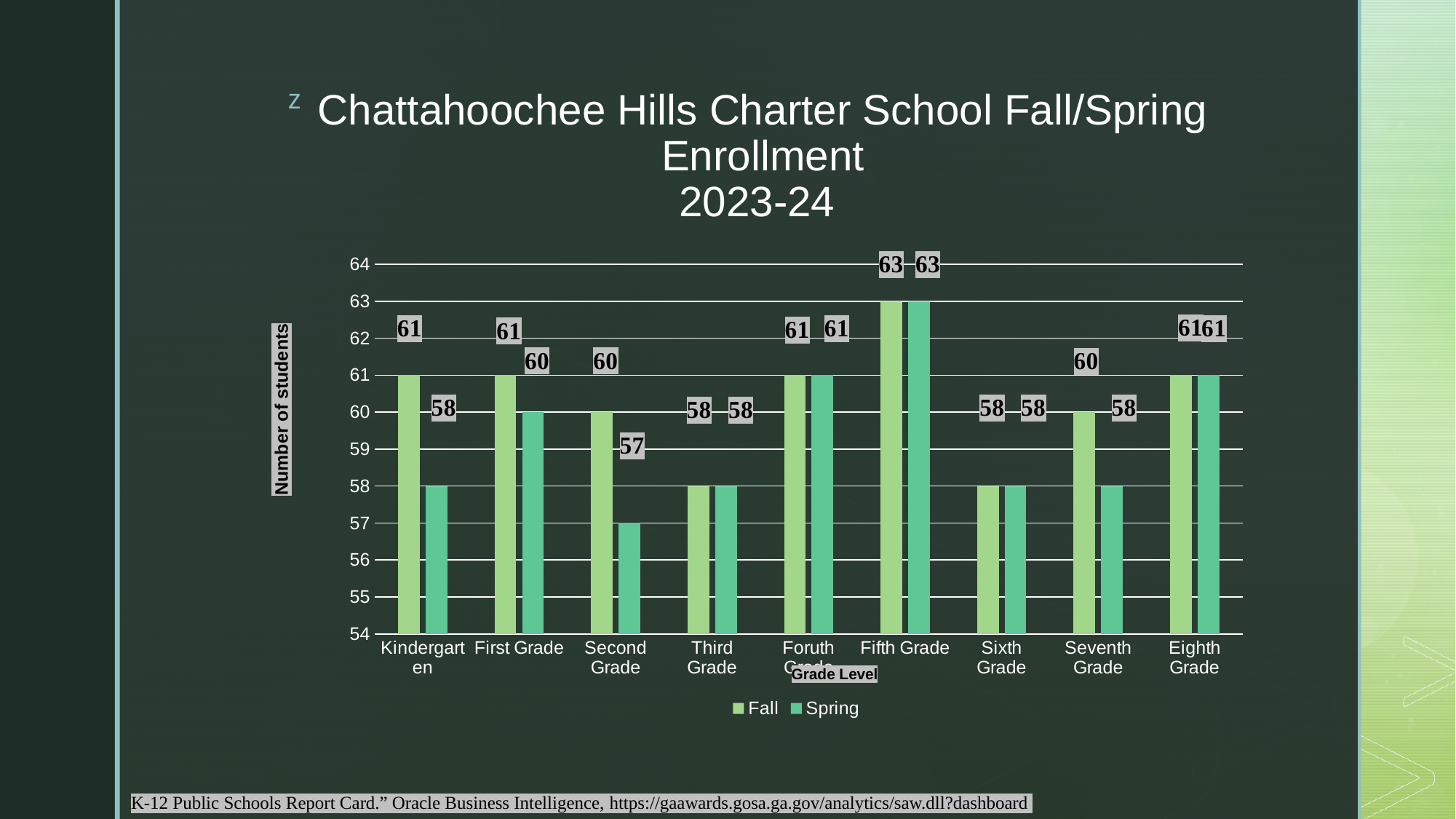
How many series does the legend list? 2 What is the Fall enrollment for Kindergarten? 61 What is the Spring enrollment for Second Grade? 57 What kind of chart is shown on the slide? Bar chart How many grade levels are shown on the x axis? 9 Which is larger for First Grade, the Fall or the Spring enrollment? Fall Which grade level has the highest Fall enrollment? Fifth Grade What is the difference between Fall and Spring enrollment for Kindergarten? 3 What is the Spring enrollment for Seventh Grade? 58 What are the two series listed in the legend? Fall and Spring What is the label of the vertical axis? Number of students Which grade level has the lowest Spring enrollment? Second Grade